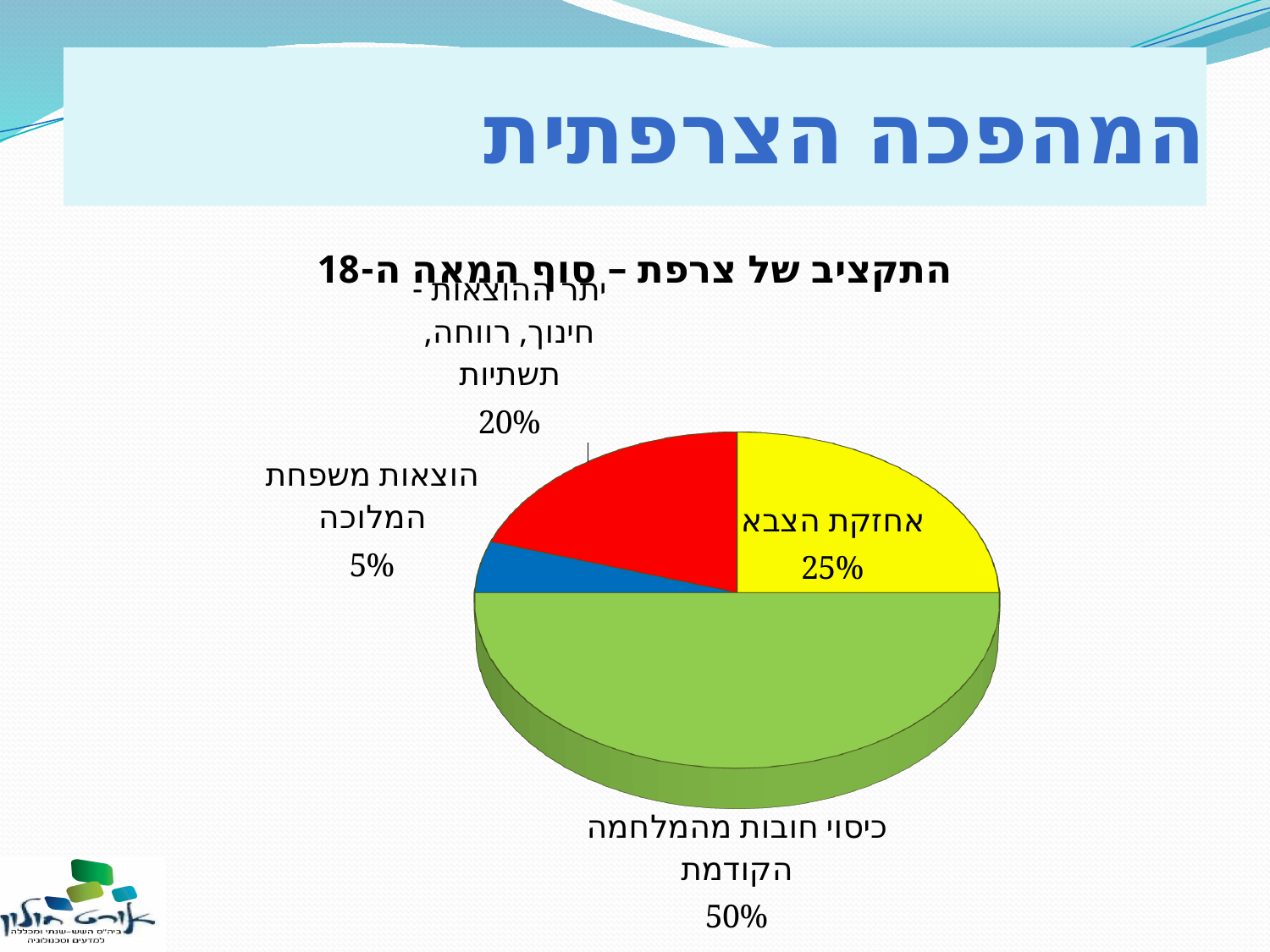
How many slices does the pie chart have? 4 What percentage of the budget goes to אחזקת הצבא? 25% Which category takes the largest share of the budget? כיסוי חובות מהמלחמה הקודמת What kind of chart is shown on the slide? pie chart What percentage of the budget goes to הוצאות משפחת המלוכה? 5% What colour is the slice for אחזקת הצבא? yellow Which is larger: the share for אחזקת הצבא or the share for יתר ההוצאות - חינוך, רווחה, תשתיות? אחזקת הצבא What percentage of the budget goes to כיסוי חובות מהמלחמה הקודמת? 50% What is the difference in percentage points between כיסוי חובות מהמלחמה הקודמת and אחזקת הצבא? 25 What is the title of the chart? התקציב של צרפת – סוף המאה ה-18 Which category takes the smallest share of the budget? הוצאות משפחת המלוכה What percentage of the budget goes to יתר ההוצאות - חינוך, רווחה, תשתיות? 20%